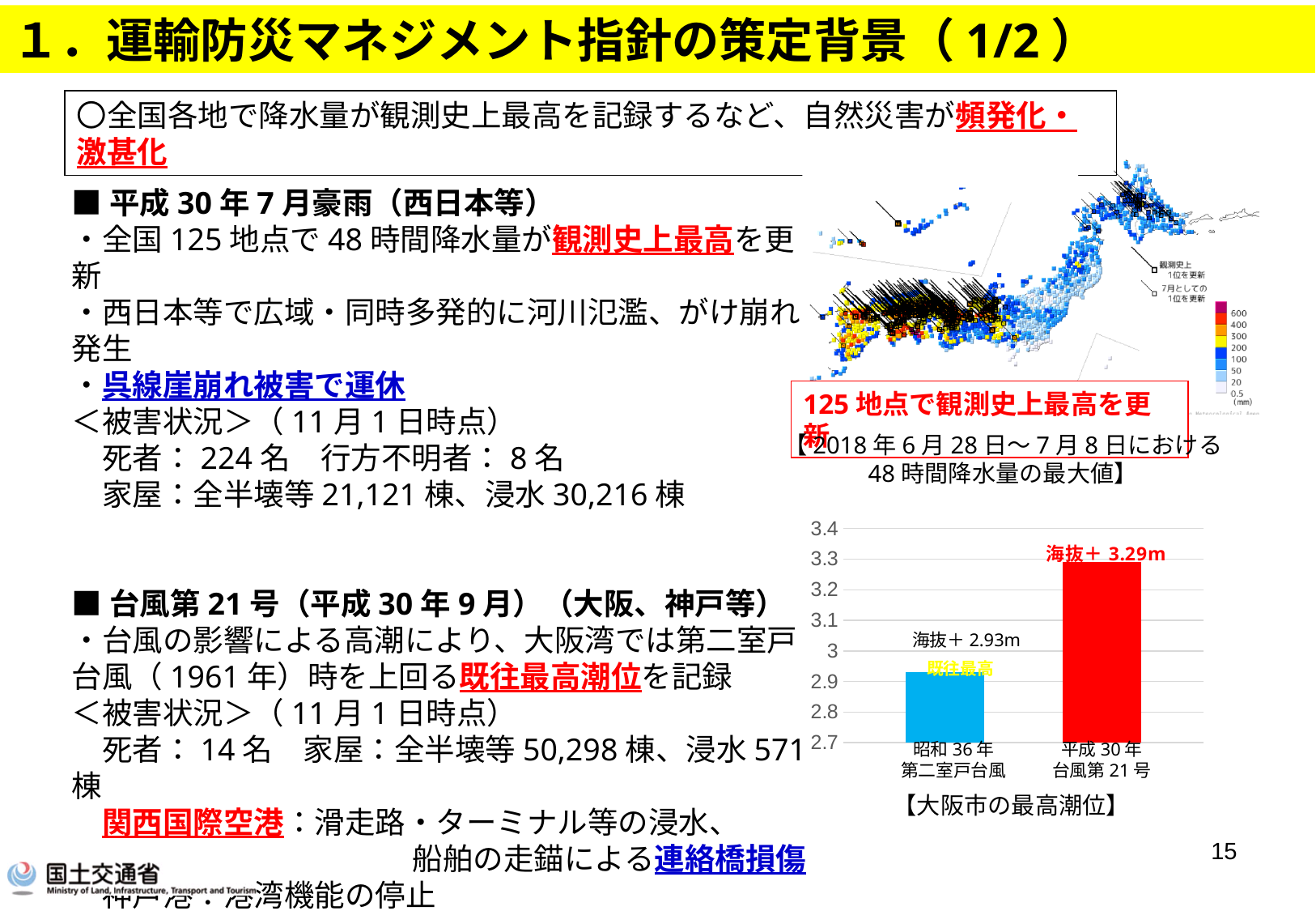
In the 【大阪市の最高潮位】 chart, is the value for 昭和36年第二室戸台風 greater or less than 3? less In the 【大阪市の最高潮位】 chart, is the value for 平成30年台風第21号 greater or less than 3.2? greater In the 【大阪市の最高潮位】 chart, what is the difference between the values for 平成30年台風第21号 and 昭和36年第二室戸台風? 0.36m In the 【大阪市の最高潮位】 chart, what is the value for 昭和36年第二室戸台風? 海抜＋2.93m In the 【大阪市の最高潮位】 chart, which category has the highest value? 平成30年台風第21号 In the 【大阪市の最高潮位】 chart, what is the value for 平成30年台風第21号? 海抜＋3.29m In the 【大阪市の最高潮位】 chart, what label is written on the bar for 昭和36年第二室戸台風? 既往最高 What kind of chart is the 【大阪市の最高潮位】 chart? bar chart How many categories are shown in the 【大阪市の最高潮位】 chart? 2 In the 【大阪市の最高潮位】 chart, what colour is the bar for 平成30年台風第21号? red In the 【大阪市の最高潮位】 chart, which category has the lowest value? 昭和36年第二室戸台風 In the 【大阪市の最高潮位】 chart, which is larger: the value for 昭和36年第二室戸台風 or the value for 平成30年台風第21号? 平成30年台風第21号